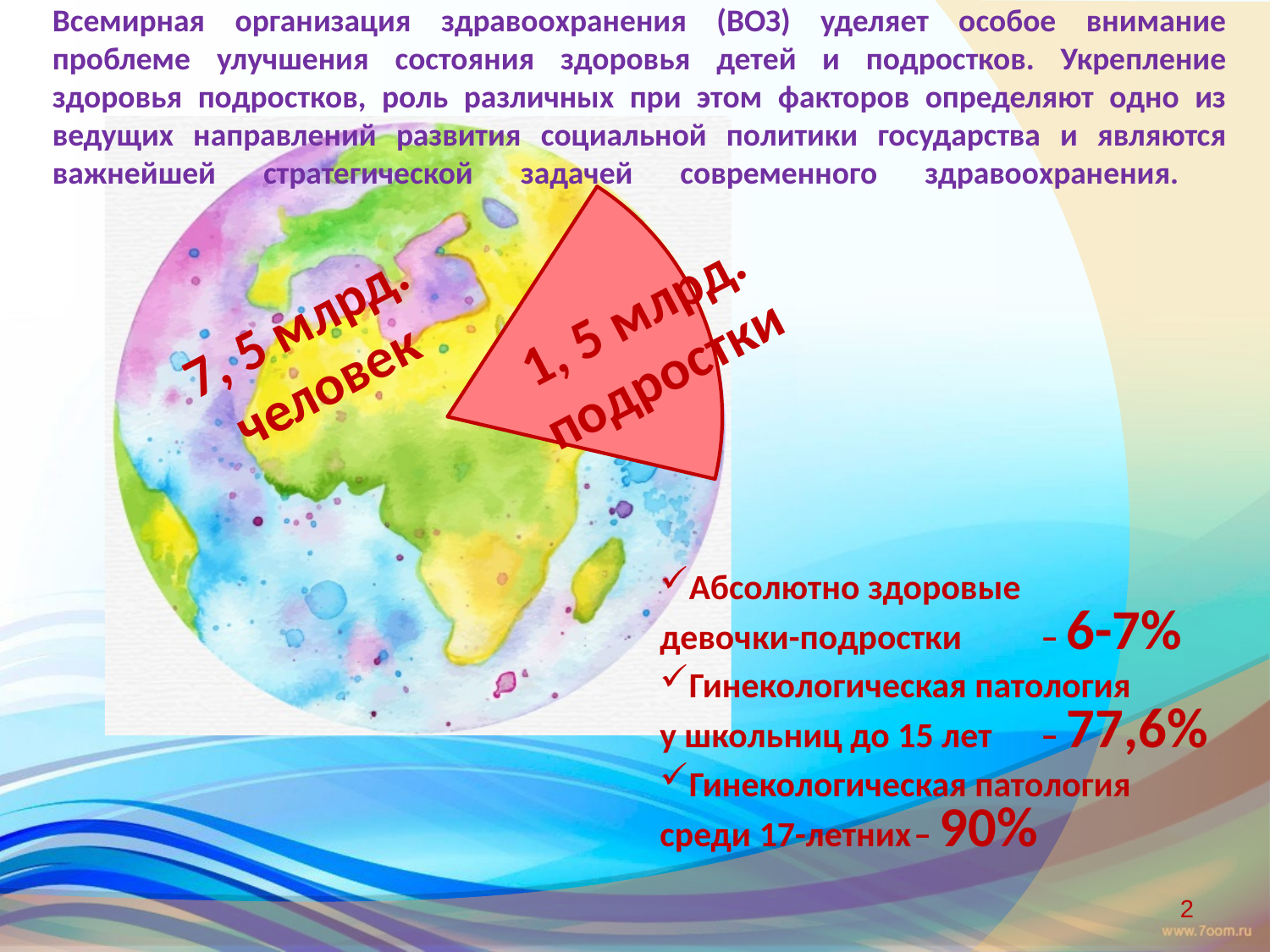
What kind of chart is shown on the globe? pie chart What share of the 7, 5 млрд. people do the 1, 5 млрд. adolescents represent? 20% How many labelled values are shown on the globe chart? 2 How many billion adolescents (подростки) does the red wedge represent? 1, 5 млрд. What value is labelled on the red wedge of the globe chart? 1, 5 млрд. подростки What total number of people is labelled on the globe chart? 7, 5 млрд. человек What is the difference between 7, 5 млрд. человек and 1, 5 млрд. подростки? 6 млрд. How many billion people (человек) does the whole globe represent? 7, 5 млрд. What colour is the wedge representing adolescents (подростки) on the globe chart? red Which is larger on the globe chart: the number of people (человек) or the number of adolescents (подростки)? человек